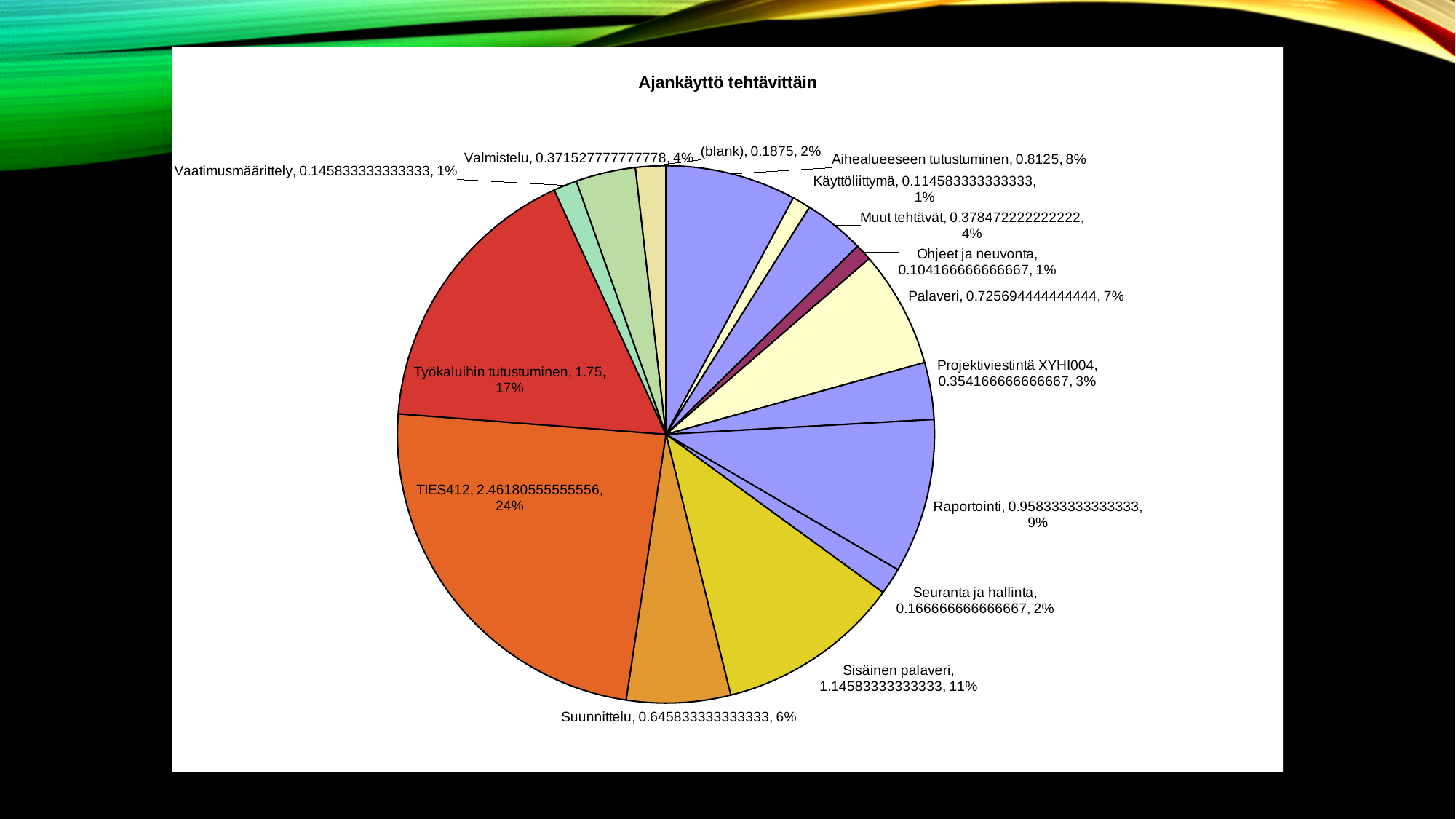
What share of the pie does TIES412 account for? 24% Which category has the largest slice of the pie? TIES412 What is the difference between the percentage shares of TIES412 and Työkaluihin tutustuminen? 7% Which is larger, the value for Raportointi or the value for Palaveri? Raportointi How many slices does the pie chart have? 15 Which category has the smallest value in the pie chart? Ohjeet ja neuvonta What share of the pie does Työkaluihin tutustuminen account for? 17% What percentage is shown for Palaveri? 7% What is the title of the chart? Ajankäyttö tehtävittäin What kind of chart is shown on the slide? pie chart What is the value shown for Raportointi? 0.958333333333333 What is the value shown for Sisäinen palaveri? 1.14583333333333